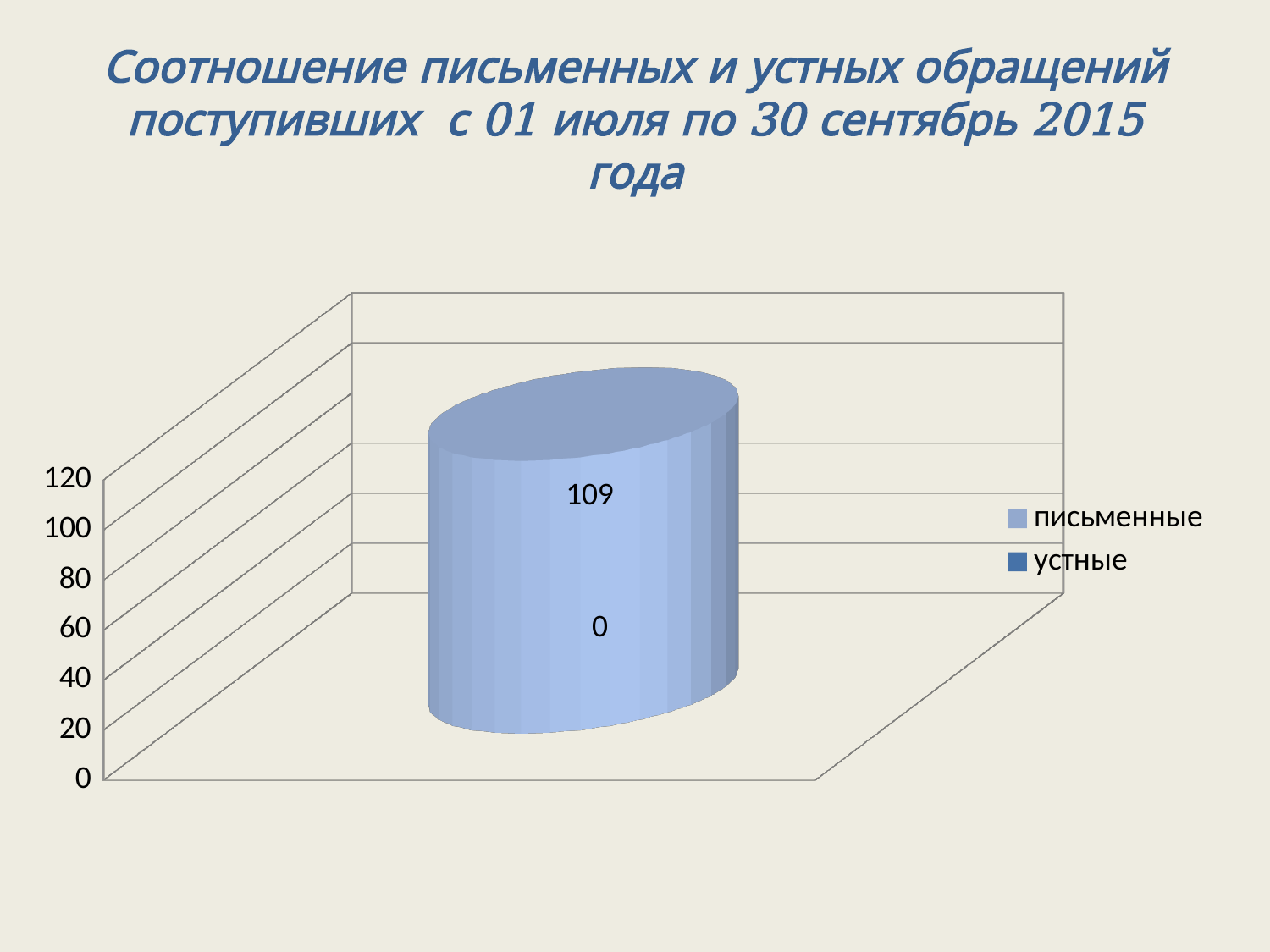
What is the highest value shown on the vertical axis? 120 What kind of chart is shown on the slide? bar chart Which series has the higher value, письменные or устные? письменные Is the value for письменные greater or less than 100? greater How many series does the legend list? 2 What is the title of the chart? Соотношение письменных и устных обращений поступивших с 01 июля по 30 сентябрь 2015 года What is the value for письменные? 109 What is the difference between the values for письменные and устные? 109 Which series has the lowest value? устные What is the value for устные? 0 Which series has the highest value? письменные